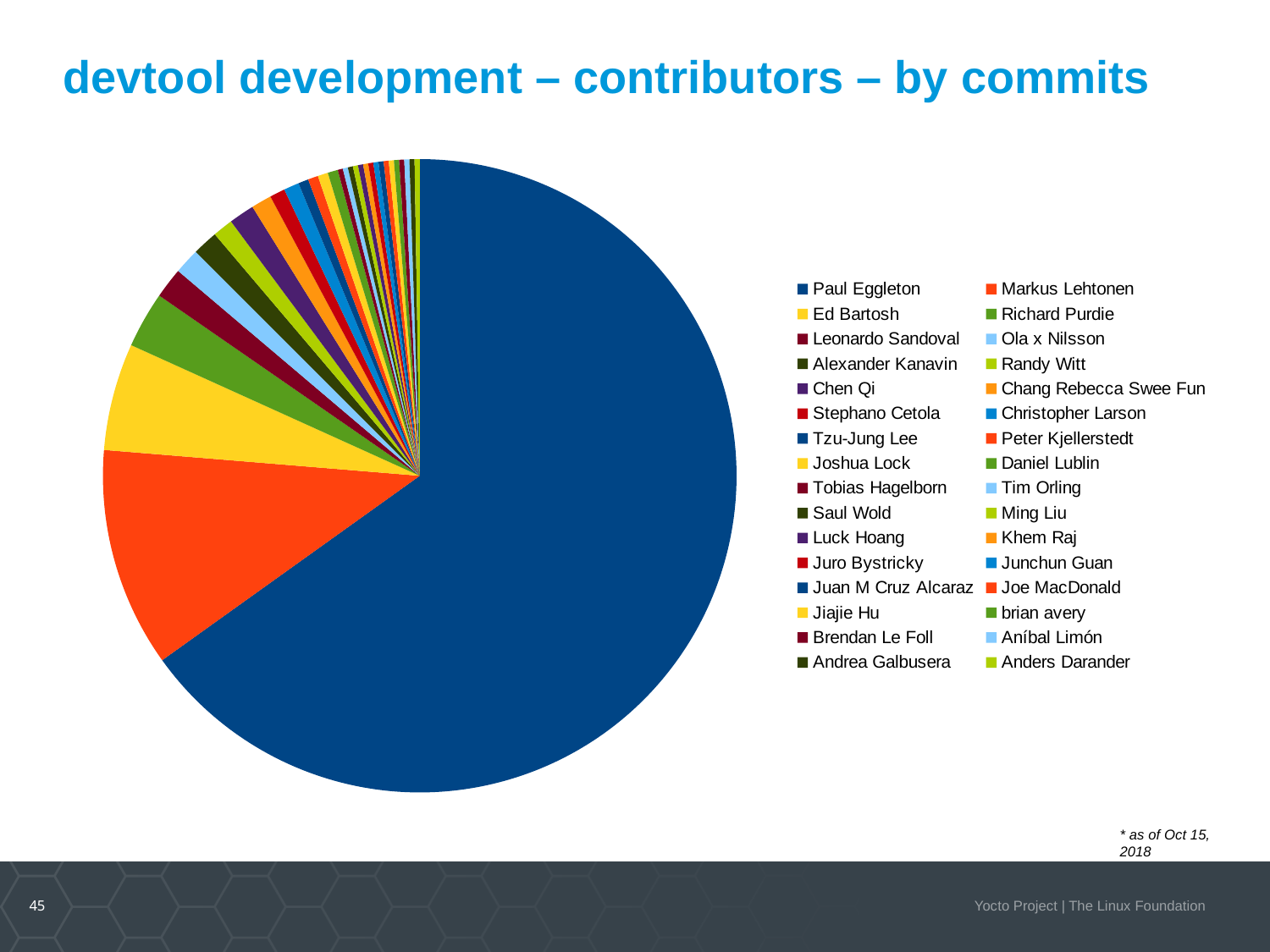
Who has more commits, Paul Eggleton or Markus Lehtonen? Paul Eggleton Which contributor has the second-largest slice of the pie chart? Markus Lehtonen What kind of chart is shown on the slide? pie chart What colour is the slice for Paul Eggleton in the pie chart? dark blue Who has more commits, Ed Bartosh or Richard Purdie? Ed Bartosh What is the title of the slide containing the pie chart? devtool development – contributors – by commits How many contributors are listed in the legend of the pie chart? 32 Does Paul Eggleton's slice account for more or less than half of the pie? more Which contributor has the largest share of commits in the pie chart? Paul Eggleton